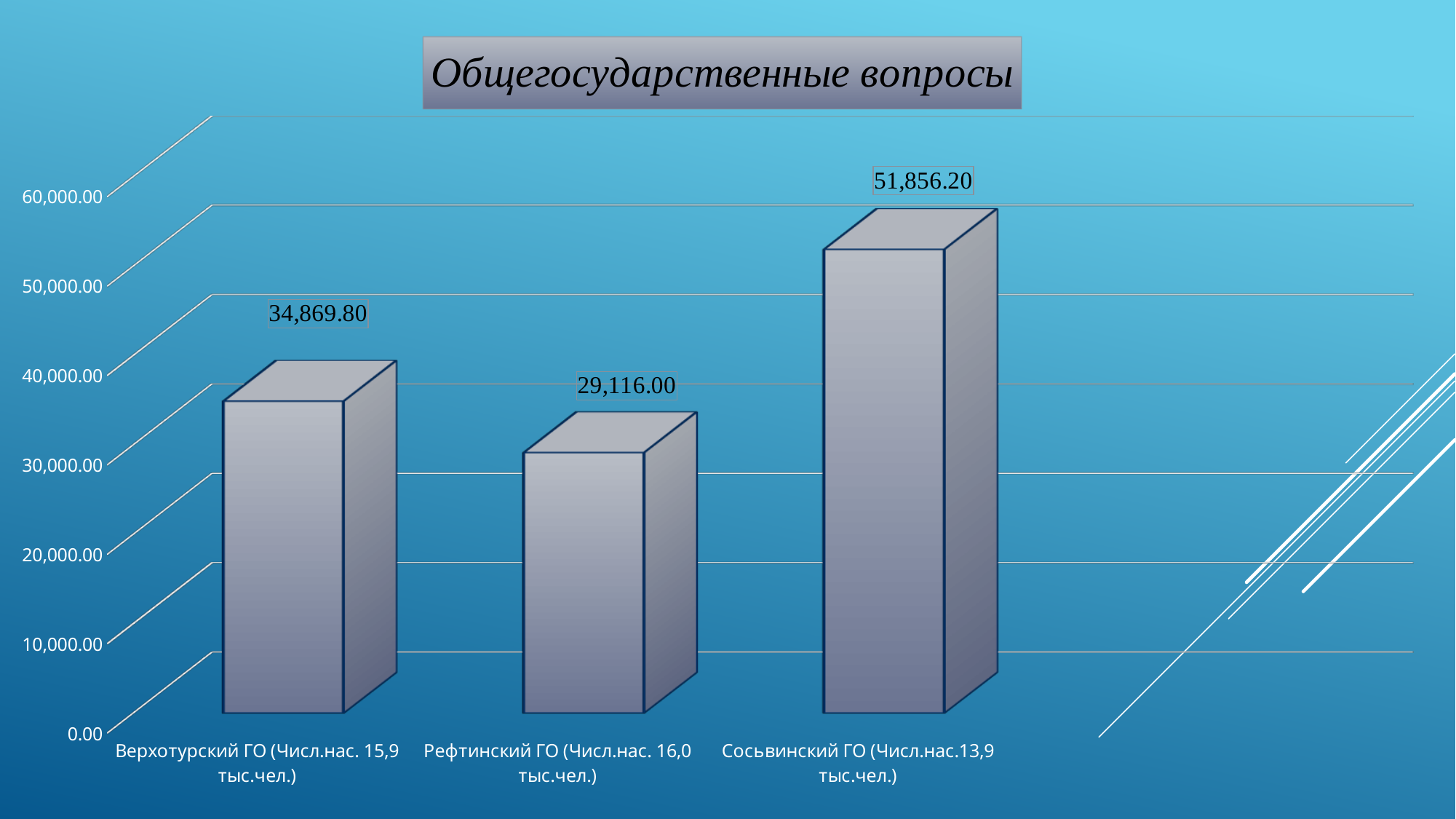
What is the difference between the values for Сосьвинский ГО and Верхотурский ГО? 16,986.40 Which category has the highest value? Сосьвинский ГО Which category has the lowest value? Рефтинский ГО What is the title of the chart? Общегосударственные вопросы How many categories are shown in the chart? 3 What is the value for Рефтинский ГО? 29,116.00 What kind of chart is shown on the slide? bar chart What is the difference between the values for Верхотурский ГО and Рефтинский ГО? 5,753.80 Which is larger, the value for Верхотурский ГО or the value for Рефтинский ГО? Верхотурский ГО Is the value for Сосьвинский ГО greater or less than 50,000.00? greater What is the value for Верхотурский ГО? 34,869.80 What is the value for Сосьвинский ГО? 51,856.20